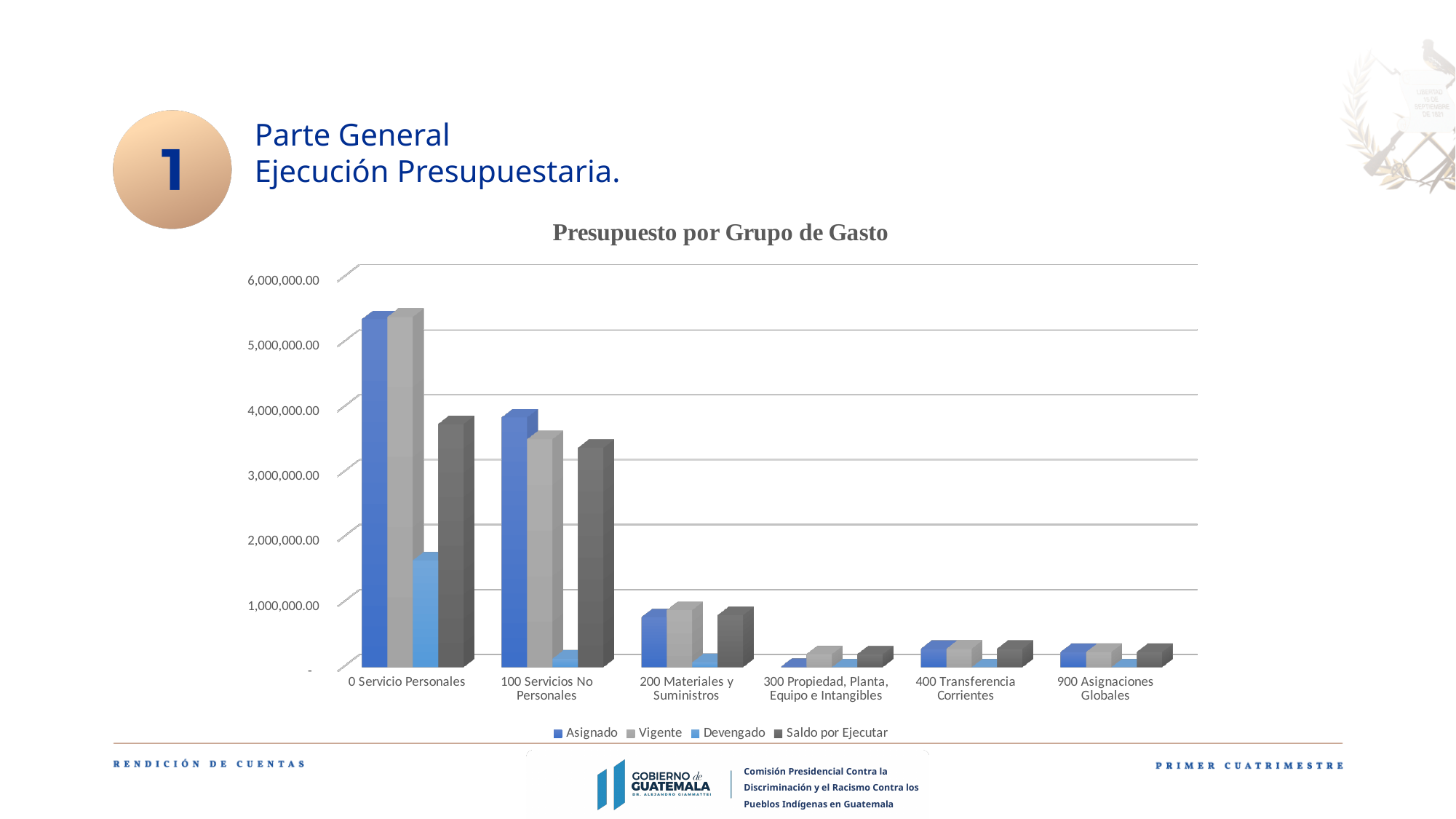
Is the Asignado value for 100 Servicios No Personales greater or less than 3,000,000.00? greater What is the title of the chart? Presupuesto por Grupo de Gasto Is the Saldo por Ejecutar value for 100 Servicios No Personales greater or less than 3,000,000.00? greater How many expense group categories are shown on the x axis of the chart? 6 Which series has the lowest value for 0 Servicio Personales? Devengado For 100 Servicios No Personales, which is larger: Asignado or Vigente? Asignado Is the Devengado value for 0 Servicio Personales greater or less than 2,000,000.00? less What kind of chart is shown on the slide? bar chart Which category has the highest Asignado value? 0 Servicio Personales How many series does the legend of the chart list? 4 For 0 Servicio Personales, which is larger: Devengado or Saldo por Ejecutar? Saldo por Ejecutar